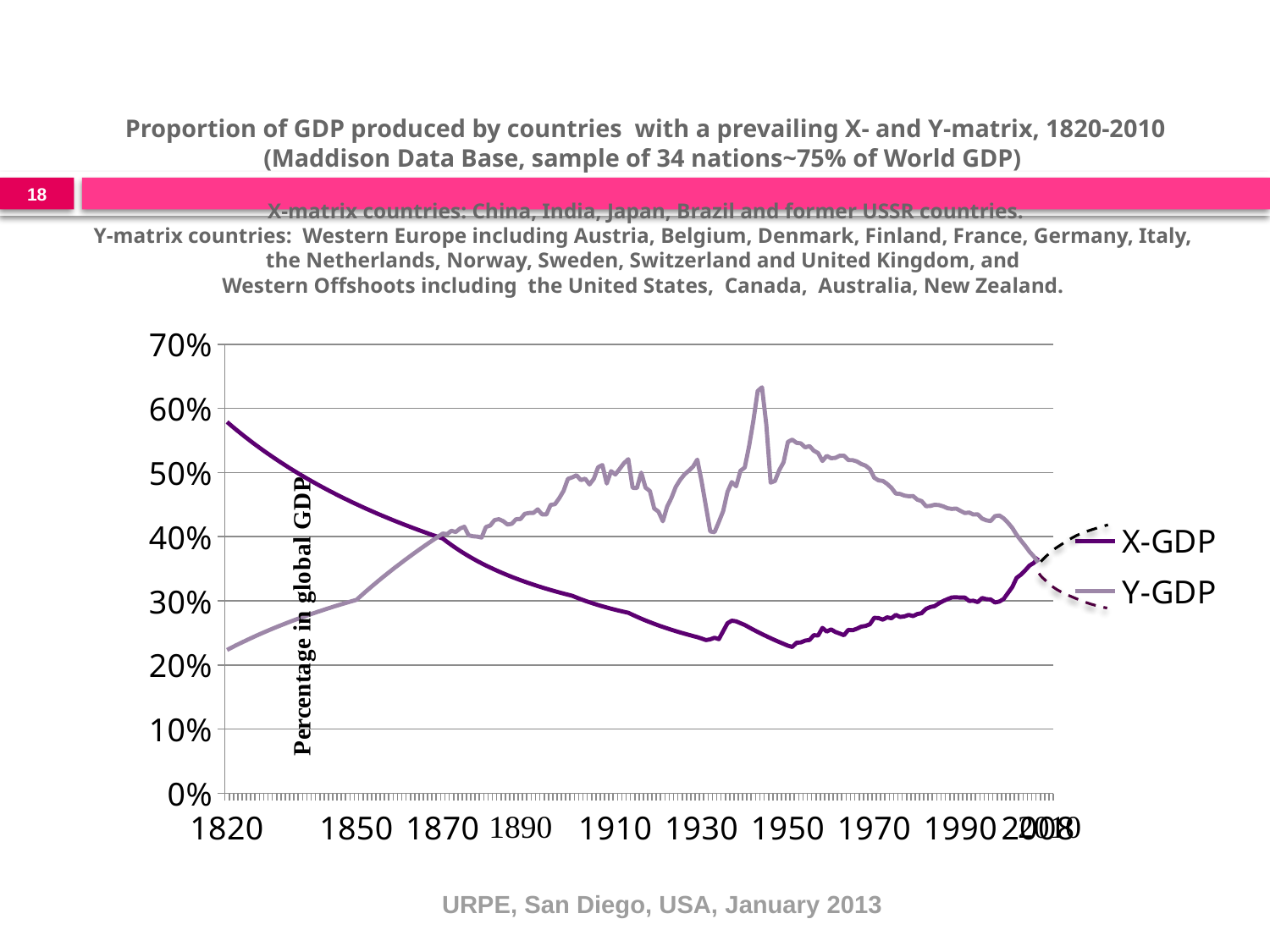
What kind of chart is shown on the slide? line chart In 1950, which series has the higher value, X-GDP or Y-GDP? Y-GDP Does the Y-GDP line rise or fall between 1820 and 1870? rise What are the two series named in the chart's legend? X-GDP and Y-GDP Is the highest value reached by Y-GDP greater or less than 60%? greater Is the value for Y-GDP in 1820 greater or less than 30%? less What is the label on the chart's vertical axis? Percentage in global GDP Is the value for X-GDP in 1950 greater or less than 30%? less How many series does the chart's legend list? 2 Does the X-GDP line rise or fall between 1820 and 1930? fall In 1820, which series has the higher value, X-GDP or Y-GDP? X-GDP